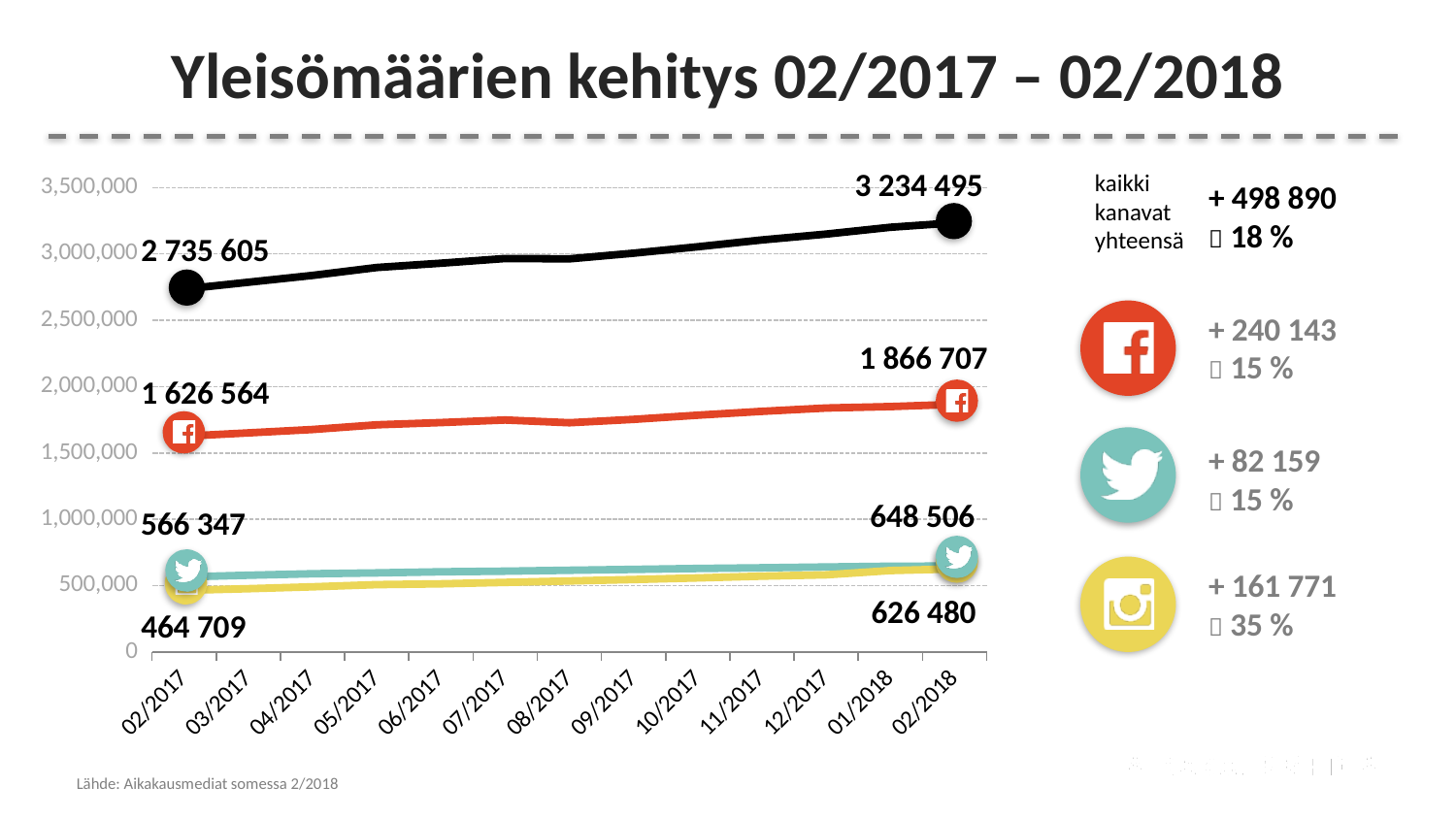
What kind of chart is shown on the slide? line chart What is the title of the chart? Yleisömäärien kehitys 02/2017 – 02/2018 What is the value of the Facebook (red) line at 02/2018? 1 866 707 What is the value of the Twitter (teal) line at 02/2017? 566 347 What is the value of the black (total) line at 02/2018? 3 234 495 Does the black (total) line rise or fall from 02/2017 to 02/2018? rise What is the difference between the Facebook (red) line's values at 02/2018 and 02/2017? 240 143 What is the value of the Instagram (yellow) line at 02/2018? 626 480 Is the Facebook (red) line's value at 02/2018 greater or less than 2,000,000? less How many months are shown on the x axis? 13 What is the value of the black (total) line at 02/2017? 2 735 605 Which is larger at 02/2018, the Twitter (teal) line or the Instagram (yellow) line? Twitter (teal), 648 506